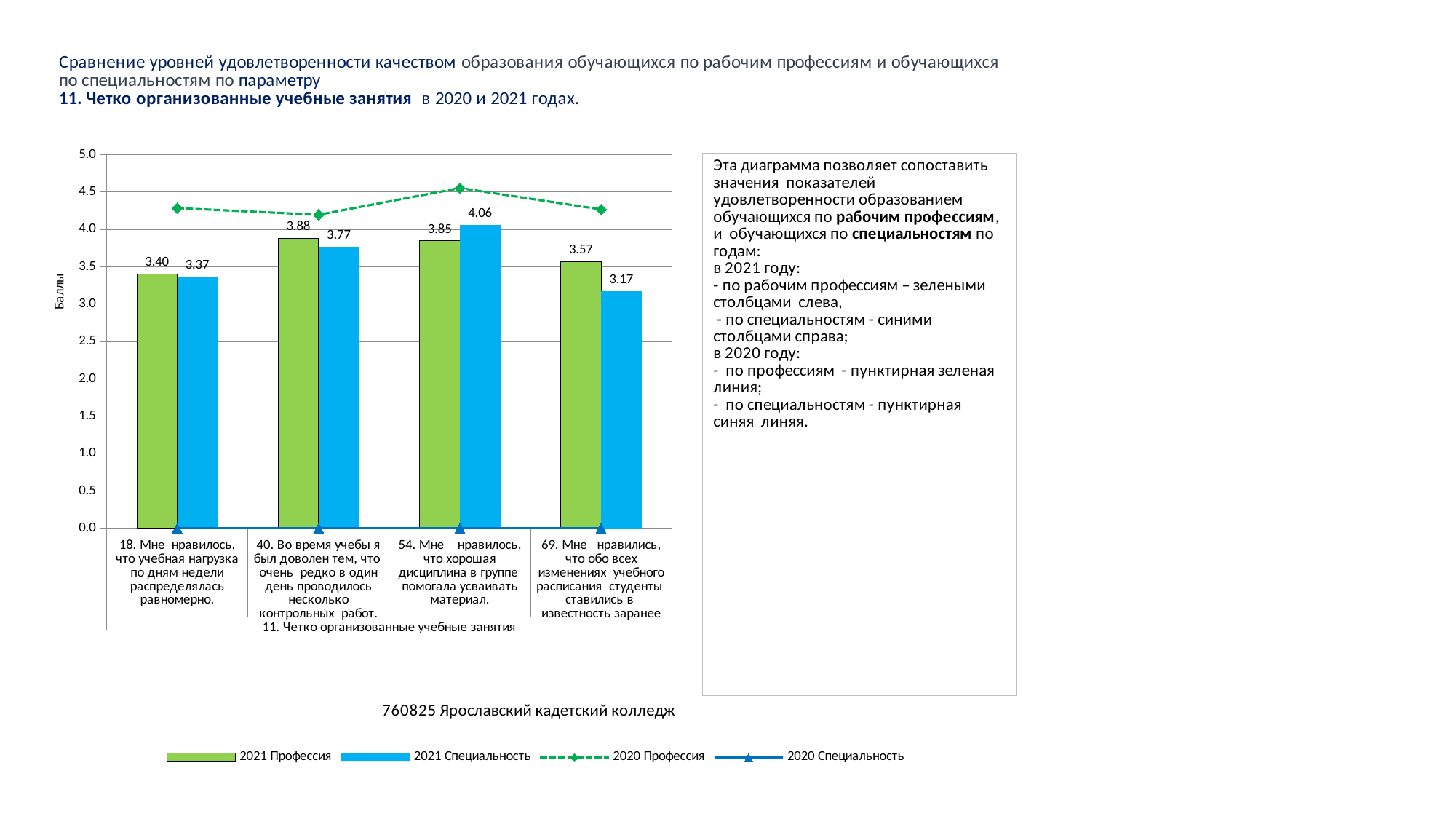
For category 54, which is larger: the 2021 Профессия bar or the 2021 Специальность bar? 2021 Специальность How many series does the legend list? 4 What is the value of the 2021 Профессия bar for category 18 (Мне нравилось, что учебная нагрузка по дням недели распределялась равномерно)? 3.40 What is the difference between the 2021 Профессия and 2021 Специальность values for category 69? 0.40 What is the label of the vertical axis? Баллы How many categories are shown on the x axis? 4 Which category has the highest 2021 Профессия bar? 40. Во время учебы я был доволен тем, что очень редко в один день проводилось несколько контрольных работ. What is the value of the 2021 Специальность bar for category 54 (Мне нравилось, что хорошая дисциплина в группе помогала усваивать материал)? 4.06 What is the value of the 2021 Специальность bar for category 69 (Мне нравились, что обо всех изменениях учебного расписания студенты ставились в известность заранее)? 3.17 What kind of chart is used for the 2021 Профессия and 2021 Специальность series? Bar chart Which category has the lowest 2021 Специальность bar? 69. Мне нравились, что обо всех изменениях учебного расписания студенты ставились в известность заранее